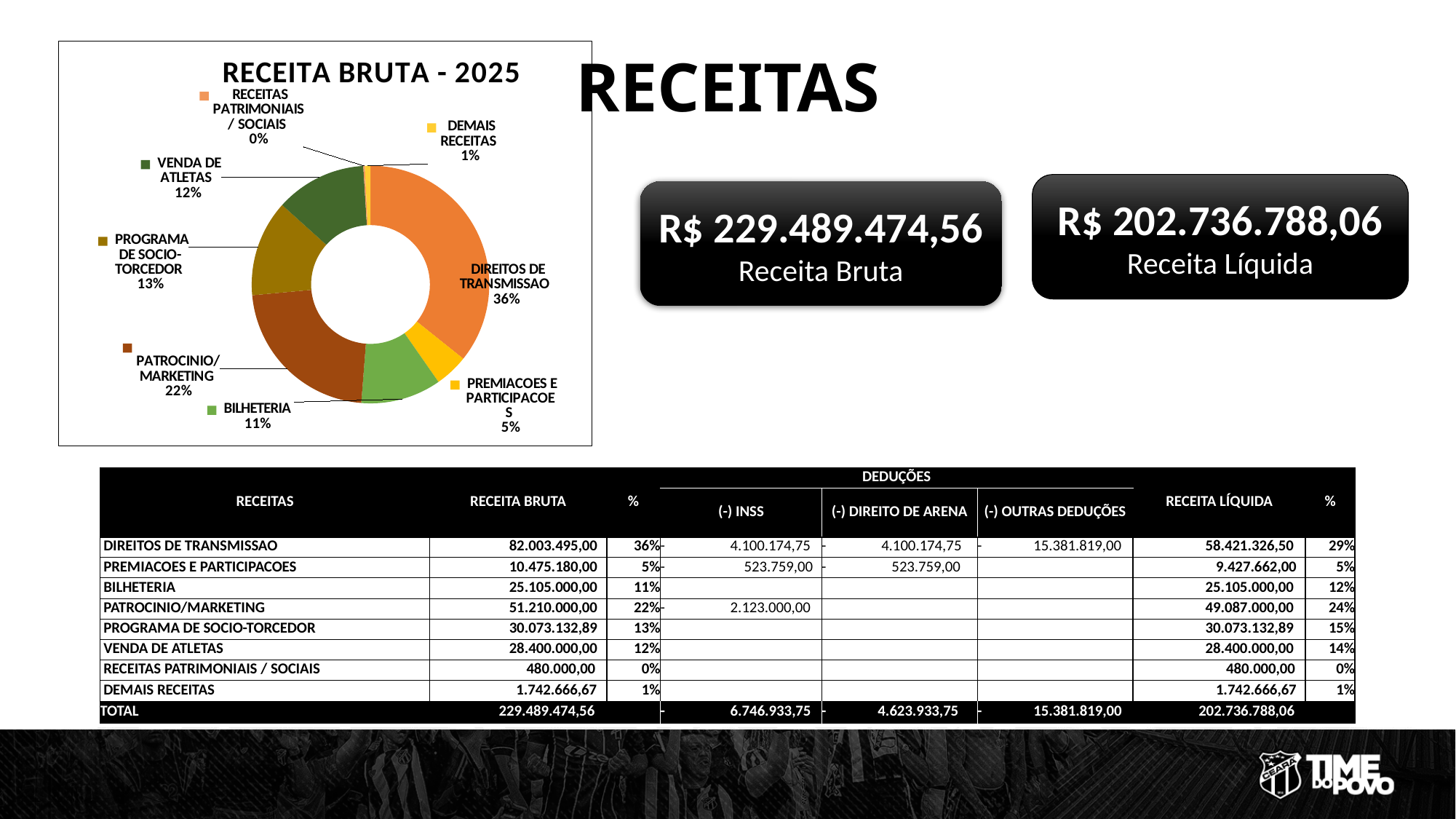
What share of the RECEITA BRUTA - 2025 chart is DIREITOS DE TRANSMISSAO? 36% How many categories are shown in the RECEITA BRUTA - 2025 chart? 8 What share does VENDA DE ATLETAS have in the RECEITA BRUTA - 2025 chart? 12% Which category has the smallest share in the RECEITA BRUTA - 2025 chart? RECEITAS PATRIMONIAIS / SOCIAIS What type of chart is RECEITA BRUTA - 2025? Doughnut (pie) chart What is the share of PROGRAMA DE SOCIO-TORCEDOR in the RECEITA BRUTA - 2025 chart? 13% What percentage does PATROCINIO/MARKETING represent in the RECEITA BRUTA - 2025 chart? 22% What percentage is shown for BILHETERIA in the RECEITA BRUTA - 2025 chart? 11% In the RECEITA BRUTA - 2025 chart, which is larger: PROGRAMA DE SOCIO-TORCEDOR or VENDA DE ATLETAS? PROGRAMA DE SOCIO-TORCEDOR What is the title of the chart on the slide? RECEITA BRUTA - 2025 In the RECEITA BRUTA - 2025 chart, what is the difference in percentage points between DIREITOS DE TRANSMISSAO and PATROCINIO/MARKETING? 14 percentage points Which category has the largest share in the RECEITA BRUTA - 2025 chart? DIREITOS DE TRANSMISSAO